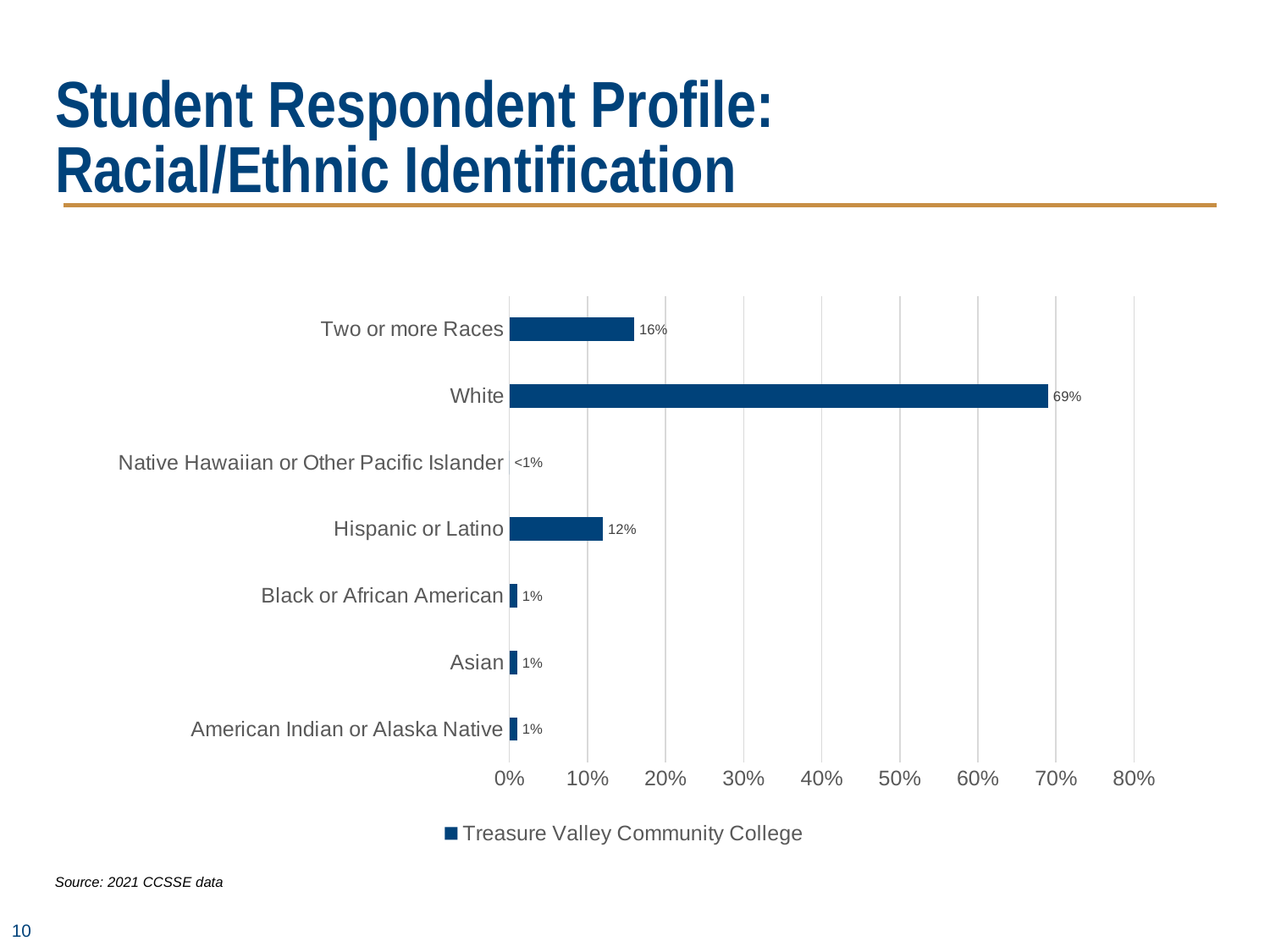
What series does the legend list? Treasure Valley Community College What type of chart is shown on the slide? Bar chart What value is shown for Native Hawaiian or Other Pacific Islander? <1% What percentage of respondents identified as White? 69% What percentage of respondents identified as Two or more Races? 16% What percentage of respondents identified as Hispanic or Latino? 12% Which racial/ethnic category has the highest percentage? White How many racial/ethnic categories are shown in the chart? 7 What is the difference in percentage points between White and Two or more Races? 53% What is the difference in percentage points between Two or more Races and Hispanic or Latino? 4% What percentage of respondents identified as Black or African American? 1% Which is larger, the percentage for Hispanic or Latino or the percentage for Two or more Races? Two or more Races